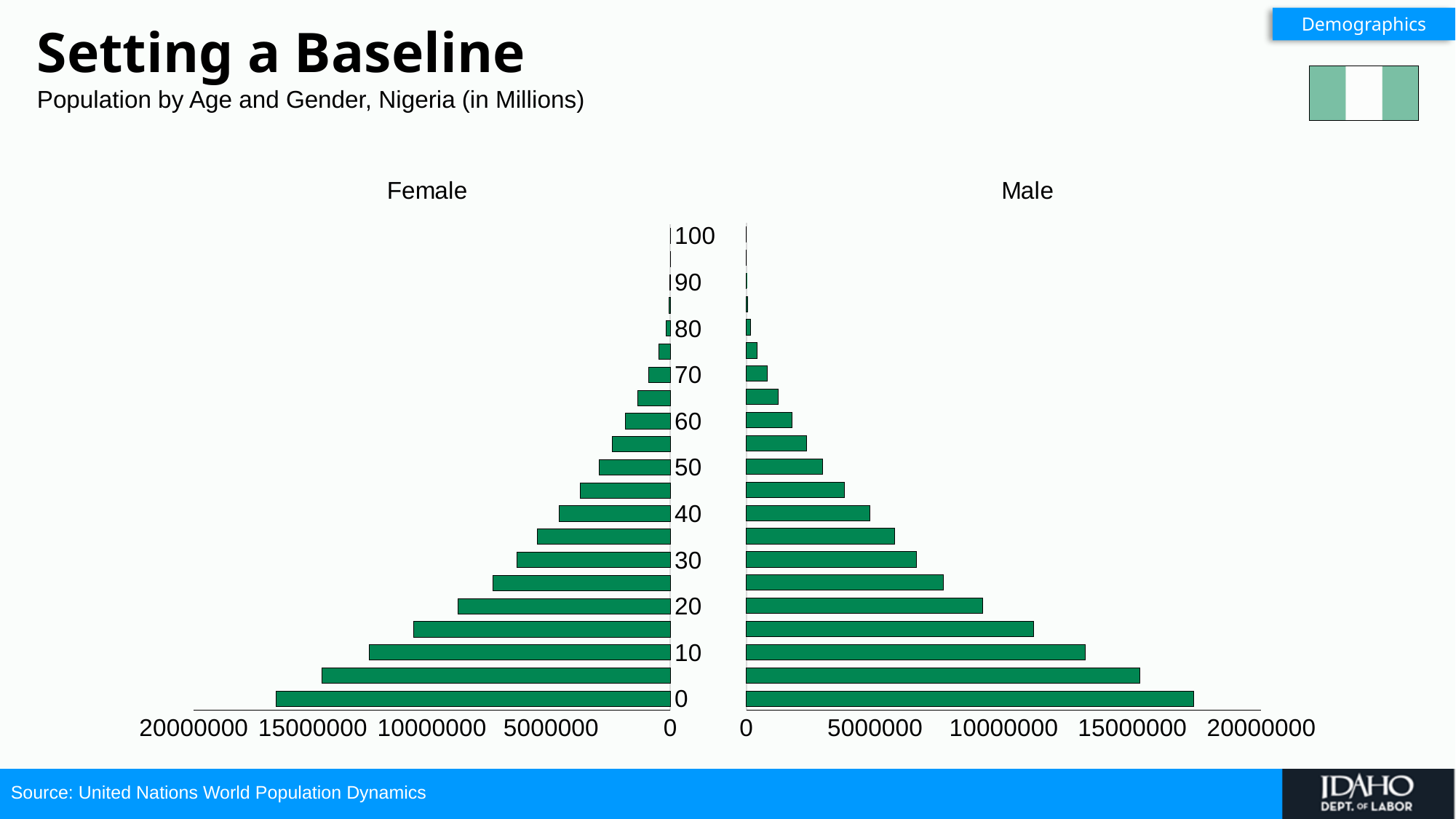
In the Female chart, is the value for age 50 greater or less than 5000000? less In the Female chart, which age group has the largest population? 0 In the Female chart, is the value for age 0 greater or less than 15000000? greater In the Male chart, is the value for age 20 greater or less than 10000000? less Comparing the two charts, is the population at age 0 larger for Male or Female? Male In the Male chart, do the bars get longer or shorter as age increases? shorter In the Male chart, which age group has the largest population? 0 What kind of chart is shown on the slide? bar chart